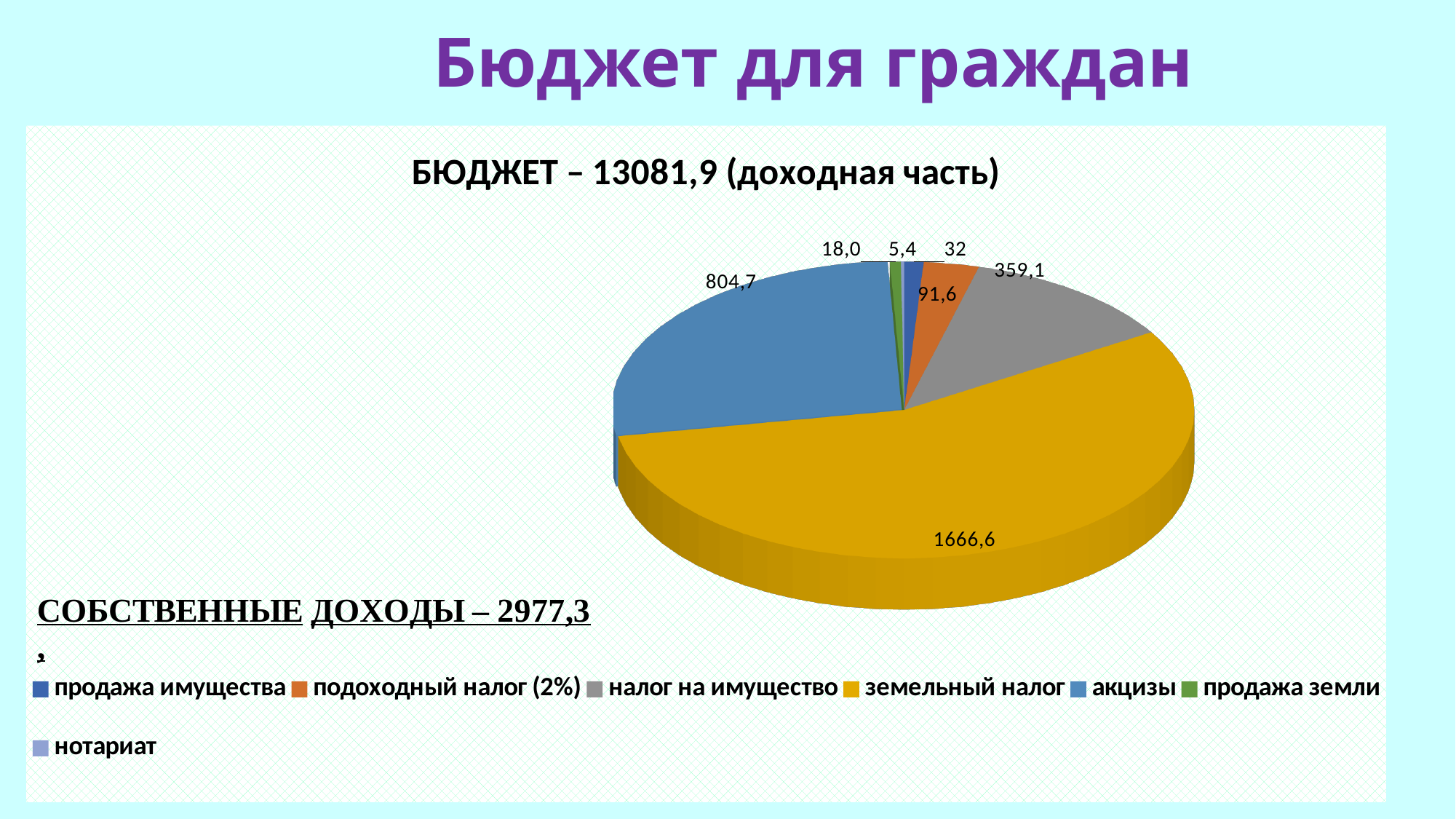
Which category has the smallest slice of the pie? нотариат Which category has the largest slice of the pie? земельный налог Which is larger, акцизы or налог на имущество? акцизы What is the difference between the values for налог на имущество and подоходный налог (2%)? 267,5 What is the value for налог на имущество? 359,1 What is the value for акцизы? 804,7 What is the difference between the values for земельный налог and акцизы? 861,9 How many categories does the legend list? 7 What type of chart is shown on the slide? pie chart What is the value for подоходный налог (2%)? 91,6 What is the title of the chart? БЮДЖЕТ – 13081,9 (доходная часть) What is the value for земельный налог? 1666,6